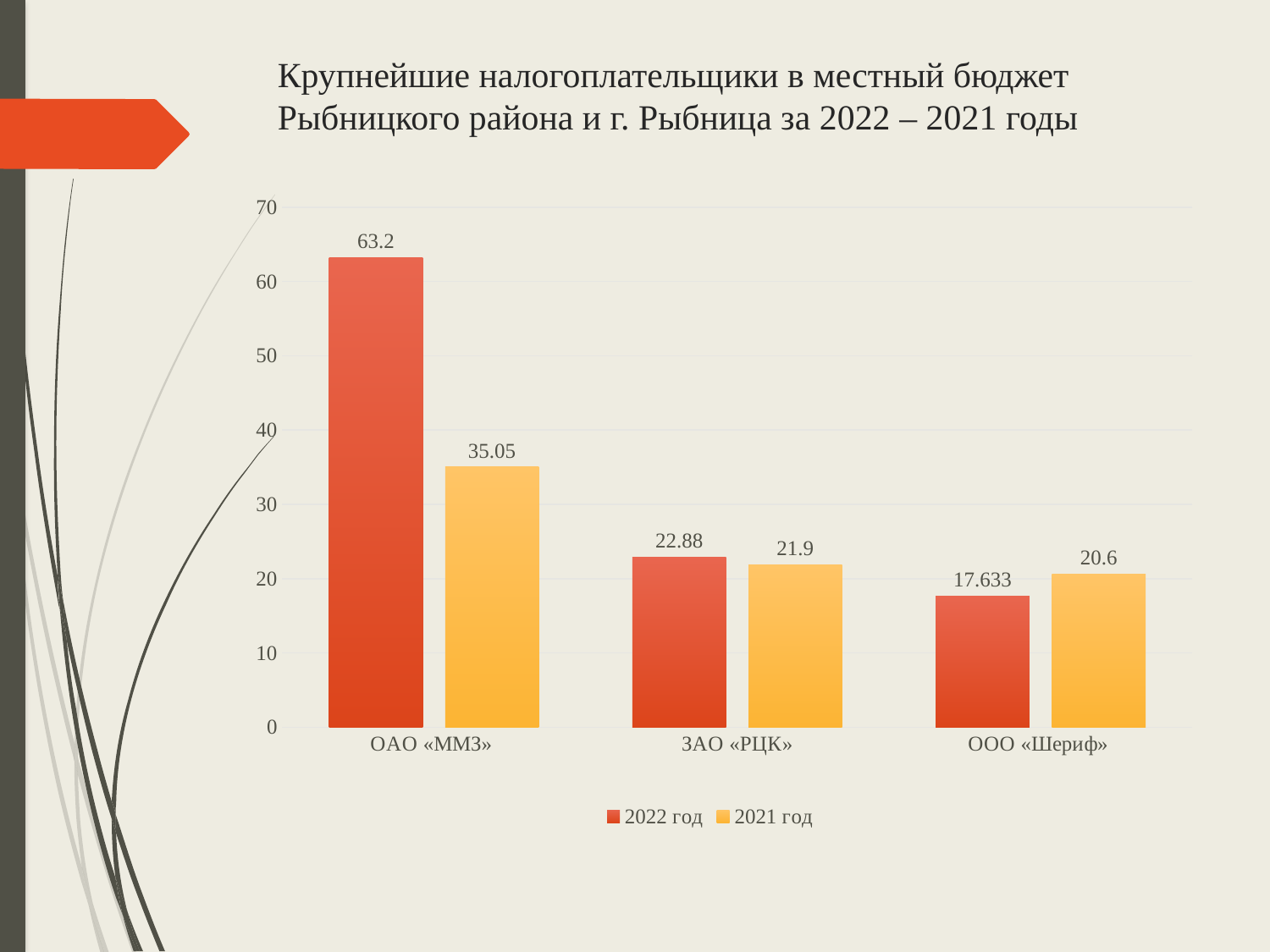
What is the value for ООО «Шериф» in the 2021 год series? 20.6 What is the value for ОАО «ММЗ» in the 2022 год series? 63.2 What kind of chart is shown on the slide? Bar chart Which category has the lowest value in the 2021 год series? ООО «Шериф» What is the value for ОАО «ММЗ» in the 2021 год series? 35.05 Which category has the highest value in the 2022 год series? ОАО «ММЗ» What is the value for ЗАО «РЦК» in the 2021 год series? 21.9 How many series does the legend list? 2 For ООО «Шериф», which series has the larger value, 2022 год or 2021 год? 2021 год How many categories are shown on the x axis? 3 What is the value for ЗАО «РЦК» in the 2022 год series? 22.88 What is the difference between the 2022 год and 2021 год values for ОАО «ММЗ»? 28.15